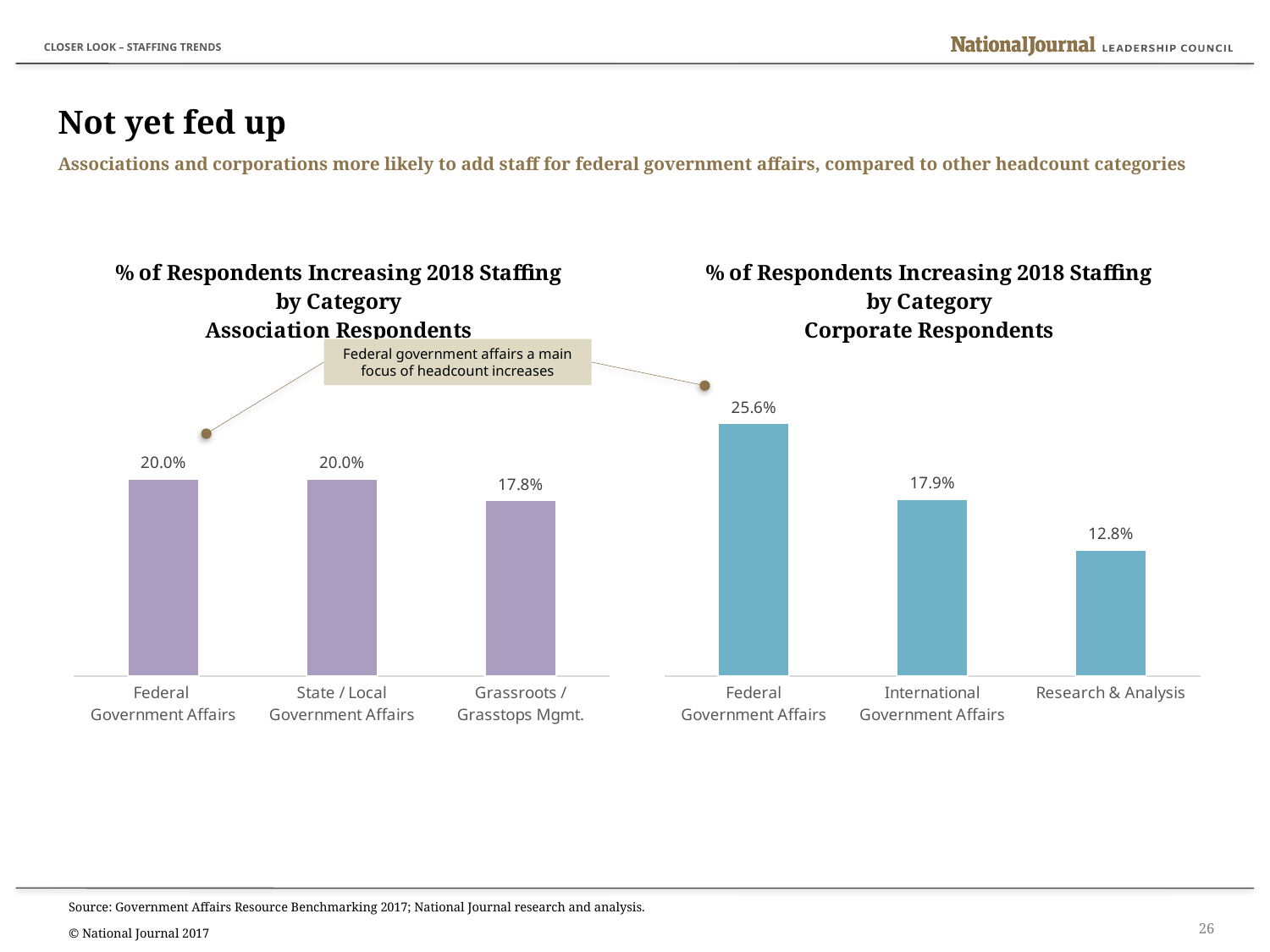
In the Corporate Respondents chart, which category has the lowest value? Research & Analysis Which is larger: Federal Government Affairs in the Corporate Respondents chart or Federal Government Affairs in the Association Respondents chart? Corporate Respondents In the Association Respondents chart, what is the value for Federal Government Affairs? 20.0% In the Corporate Respondents chart, which category has the highest value? Federal Government Affairs In the Association Respondents chart, which category has the lowest value? Grassroots / Grasstops Mgmt. In the Corporate Respondents chart, what is the value for Research & Analysis? 12.8% In the Association Respondents chart, what is the difference between State / Local Government Affairs and Grassroots / Grasstops Mgmt.? 2.2% How many categories are shown in the Corporate Respondents chart? 3 In the Association Respondents chart, what is the value for Grassroots / Grasstops Mgmt.? 17.8% In the Corporate Respondents chart, what is the value for International Government Affairs? 17.9% What type of chart is the Association Respondents chart? Bar chart In the Corporate Respondents chart, what is the difference between Federal Government Affairs and Research & Analysis? 12.8%